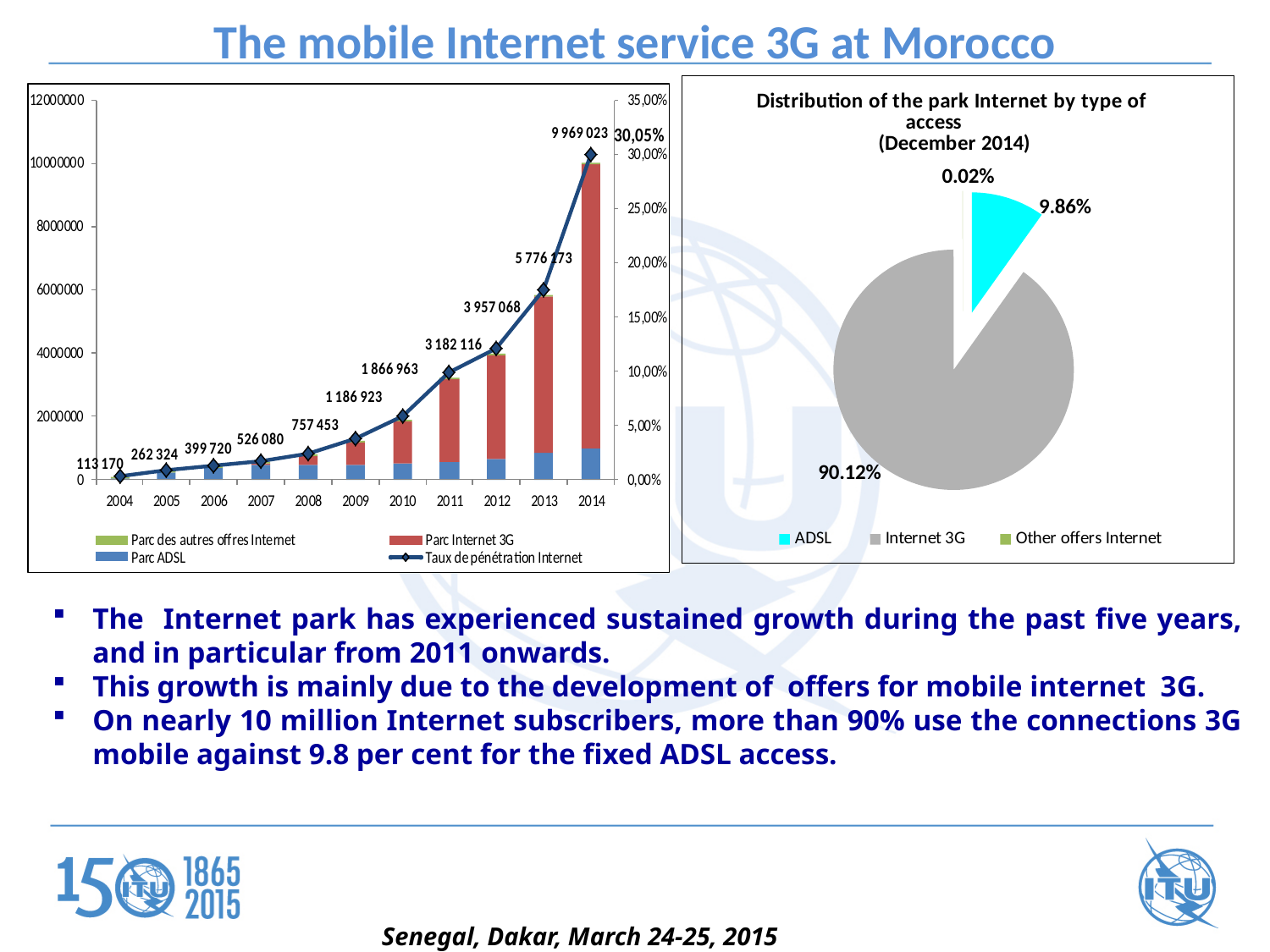
What kind of chart is the chart on the right of the slide? Pie chart How many types of access does the legend of the pie chart on the right list? 3 How many series does the legend of the left chart list? 4 In the left chart, what is the total Internet park value labelled for 2014? 9 969 023 In the pie chart on the right, which type of access has the largest slice? Internet 3G In the pie chart on the right, what share of the Internet park is Internet 3G? 90.12% In the left chart, what is the total Internet park value labelled for 2011? 3 182 116 In the left chart, do the total Internet park values rise or fall from 2004 to 2014? Rise In the pie chart on the right, which type of access has the smallest slice? Other offers Internet In the left chart, what is the Internet penetration rate (Taux de pénétration Internet) labelled for 2014? 30,05% In the left chart, what is the difference between the total labelled for 2014 and the total labelled for 2013? 4 192 850 In the pie chart on the right, what share of the Internet park is ADSL? 9.86%